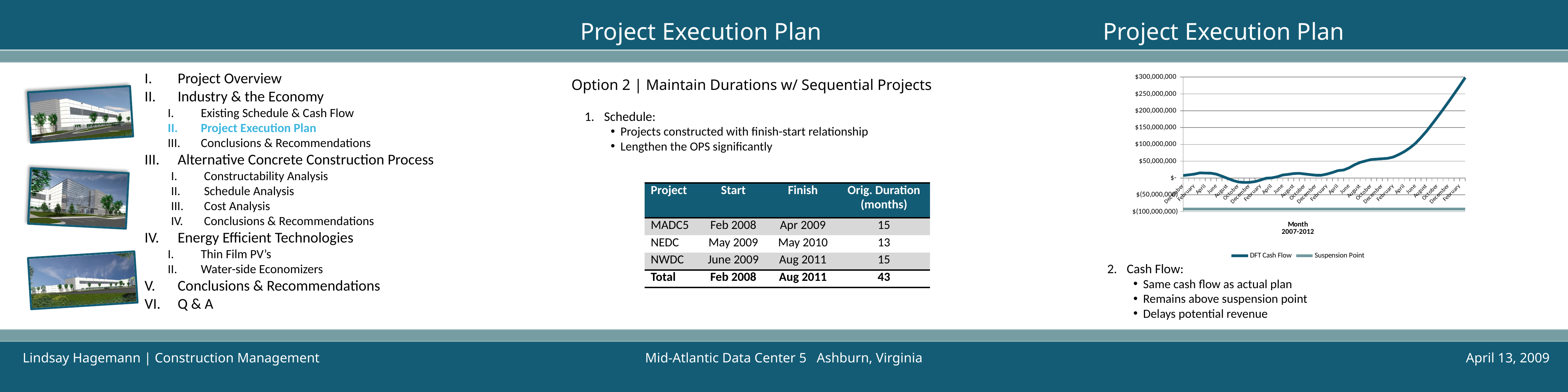
What is the title of the chart's x axis? Month 2007-2012 What kind of chart is shown on the slide? line chart What is the highest value labelled on the chart's y axis? $300,000,000 Does the DFT Cash Flow line overall rise or fall from left to right along the x axis? rise At the right end of the chart, which series has the higher value, DFT Cash Flow or Suspension Point? DFT Cash Flow Is the final value of the DFT Cash Flow line greater or less than $250,000,000? greater How many series does the chart's legend list? 2 What are the two series named in the chart's legend? DFT Cash Flow and Suspension Point Is the Suspension Point line above or below the $(50,000,000) gridline? below Is the DFT Cash Flow value at the start of the chart greater or less than $100,000,000? less